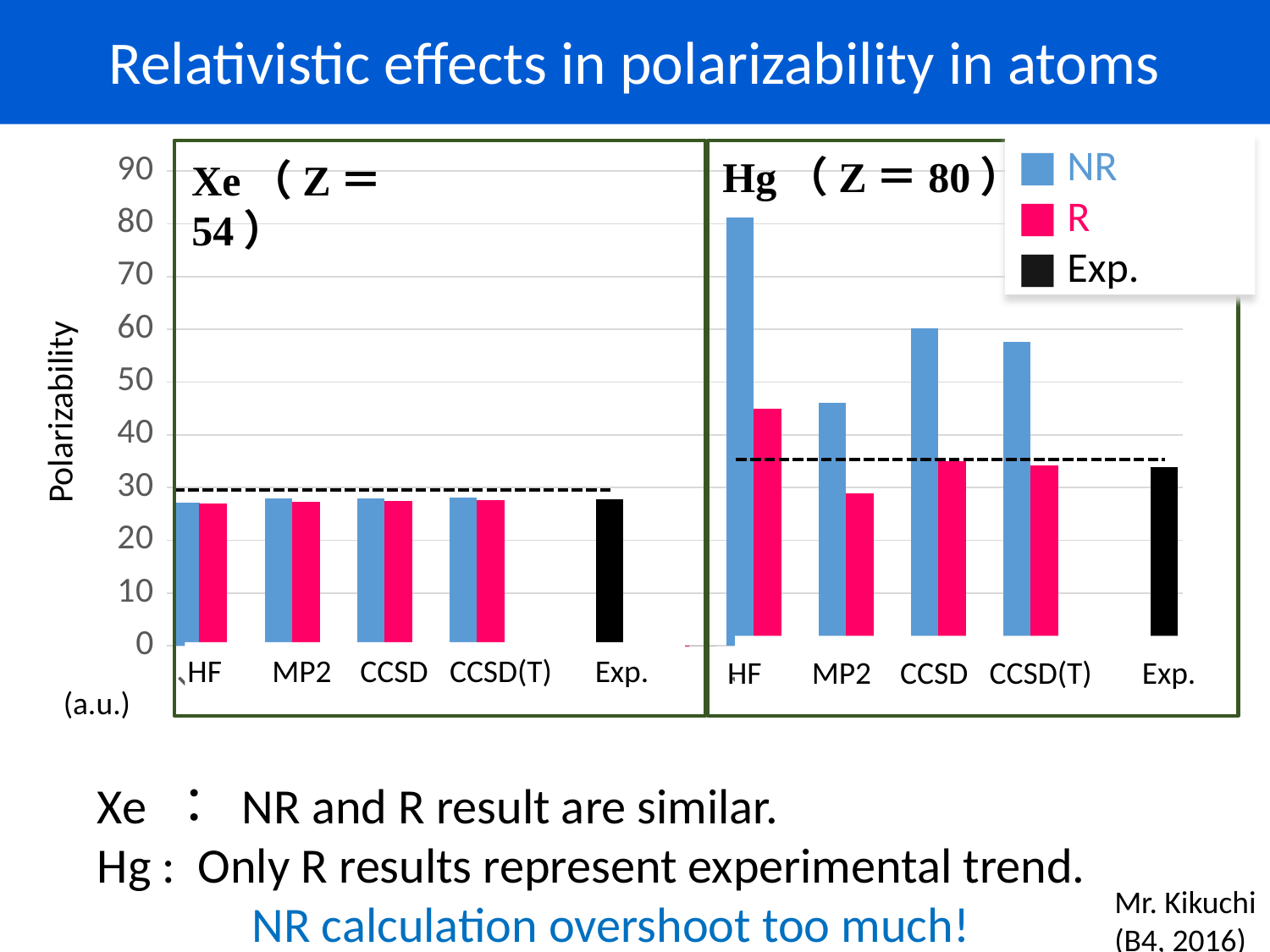
How many categories are shown on the x axis of the Hg (Z = 80) chart? 5 In the Hg (Z = 80) chart, which is larger for HF, the NR value or the R value? NR In the Hg (Z = 80) chart, is the NR value for CCSD greater or less than 50? greater In the Xe (Z = 54) chart, is the NR value for CCSD(T) greater or less than 30? less What is the label on the y axis of the charts? Polarizability In the Hg (Z = 80) chart, is the NR value for HF greater or less than 70? greater In the Hg (Z = 80) chart, which method has the highest NR bar? HF What kind of chart is used for the Xe (Z = 54) panel? bar chart How many series does the legend list? 3 In the Hg (Z = 80) chart, which is larger for MP2, the NR value or the R value? NR In the Hg (Z = 80) chart, which method has the lowest NR bar? MP2